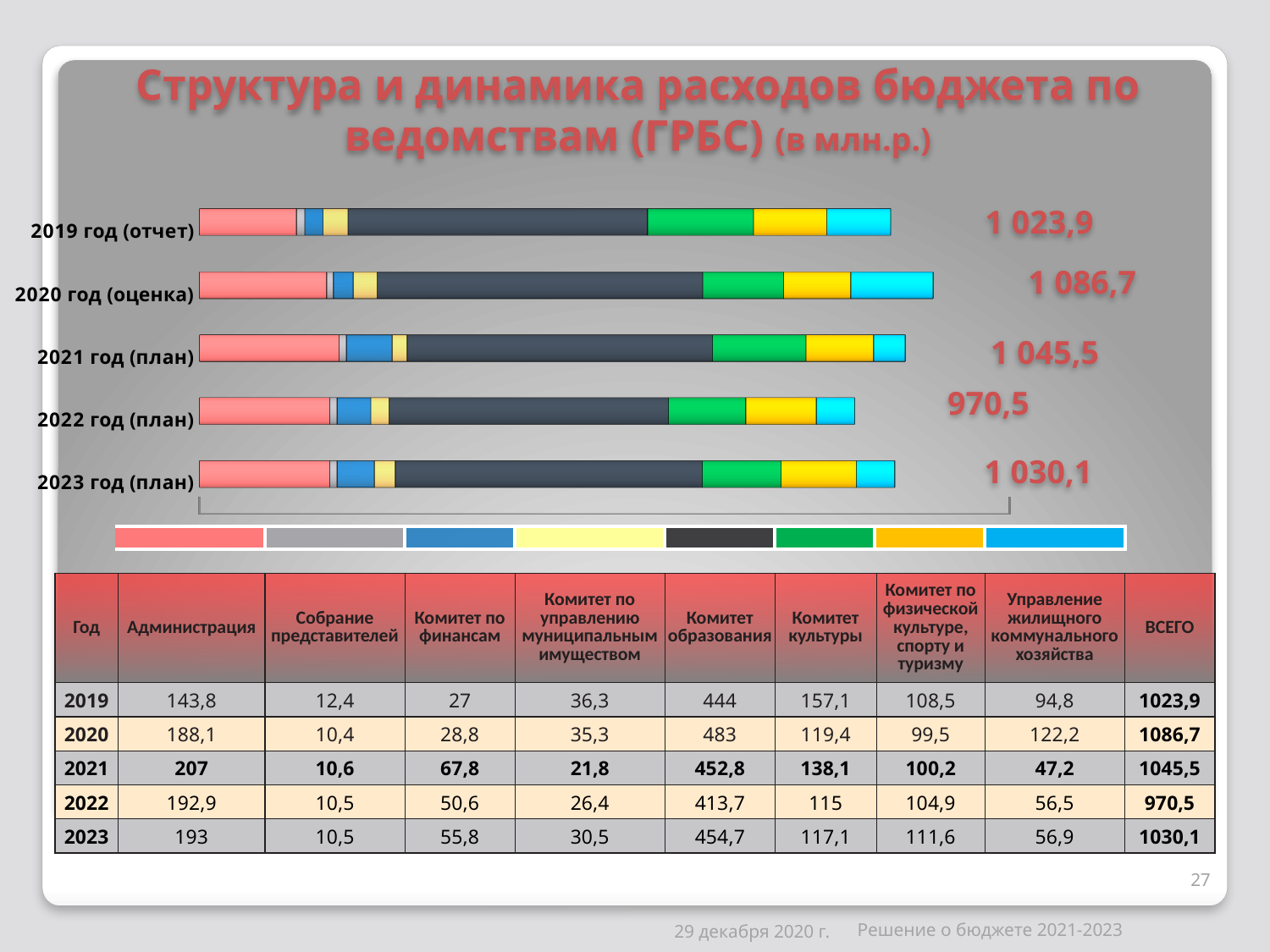
How many colour entries does the legend below the chart show? 8 Which total is larger, 2019 год (отчет) or 2023 год (план)? 2023 год (план) By how much does the 2020 total exceed the 2019 total? 62,8 According to the table, what is the value for Администрация in 2019? 143,8 Which year's bar has the lowest total? 2022 год (план) What kind of chart is shown on the slide? stacked bar chart According to the table, what is the value for Комитет образования in 2021? 452,8 What is the total labelled for the bar "2022 год (план)"? 970,5 Which year's bar has the highest total? 2020 год (оценка) How many bars (years) are plotted in the chart? 5 What is the title of the chart? Структура и динамика расходов бюджета по ведомствам (ГРБС) (в млн.р.) What is the total labelled for the bar "2019 год (отчет)"? 1 023,9